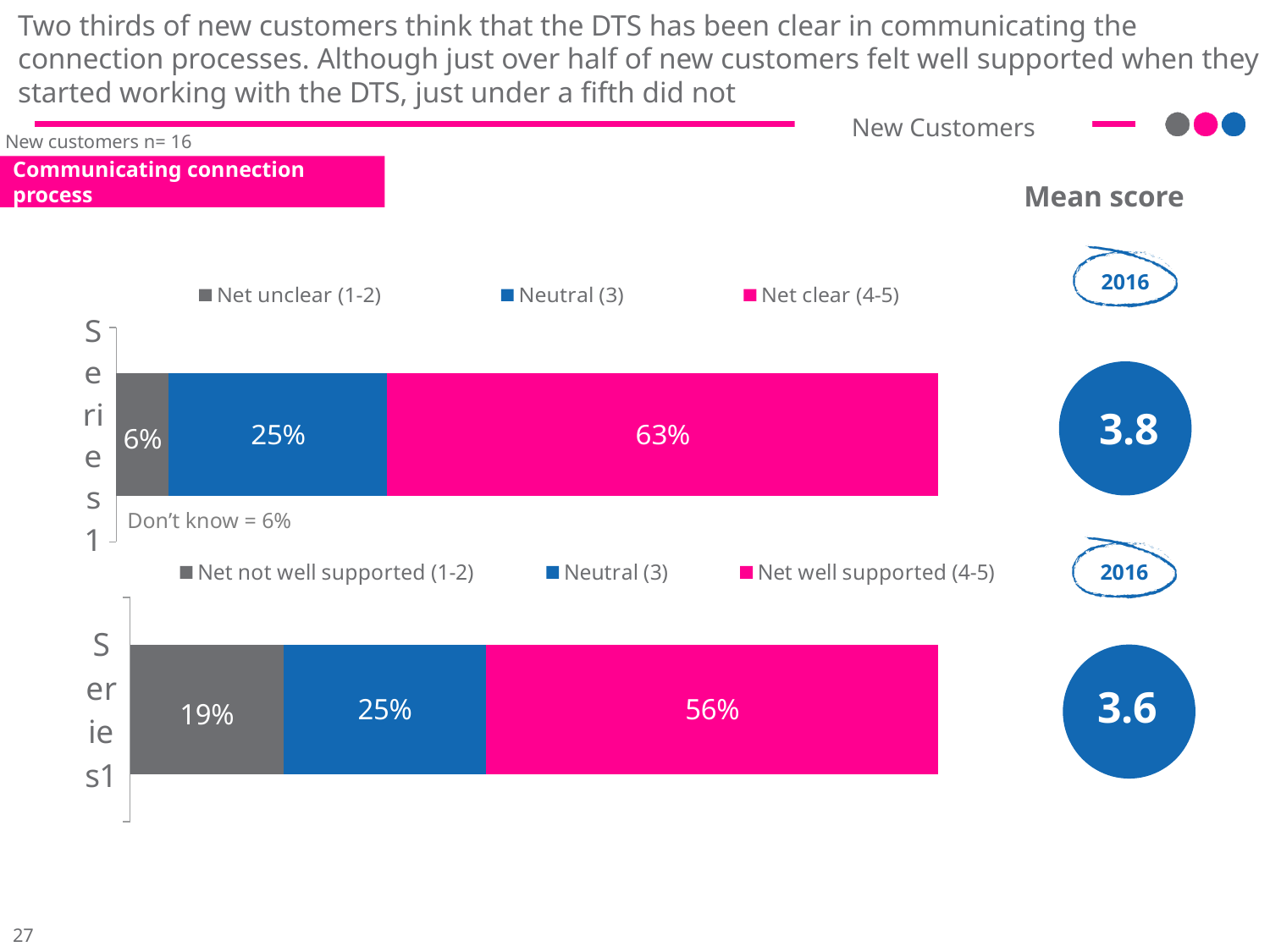
In the bottom chart, what percentage is shown for Net not well supported (1-2)? 19% What type of chart is the top chart? Stacked bar chart In the bottom chart, what percentage is shown for Net well supported (4-5)? 56% In the top chart, what percentage is shown for Net unclear (1-2)? 6% In the bottom chart, what is the difference between the Net well supported (4-5) and Net not well supported (1-2) percentages? 37% In the top chart, what percentage is shown for Neutral (3)? 25% In the top chart, what percentage is shown for Net clear (4-5)? 63% In the top chart, what is the difference between the Net clear (4-5) and Neutral (3) percentages? 38% Which is larger: Net clear (4-5) in the top chart or Net well supported (4-5) in the bottom chart? Net clear (4-5) in the top chart In the top chart, which segment has the smallest value? Net unclear (1-2) In the bottom chart, which segment has the largest value? Net well supported (4-5) How many series does the legend of the bottom chart list? 3